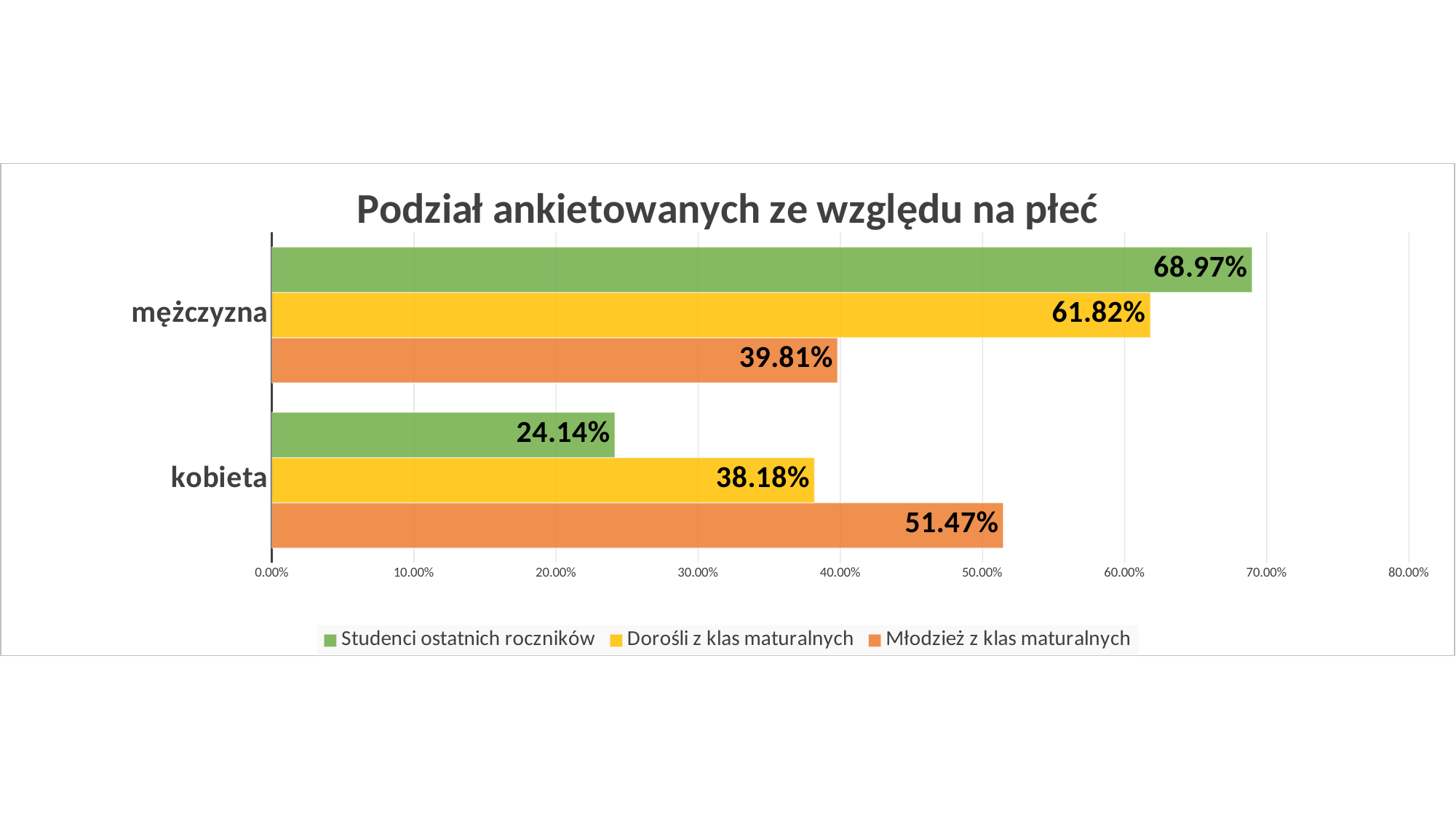
What is the value for mężczyzna in the Studenci ostatnich roczników series? 68.97% What is the title of the chart? Podział ankietowanych ze względu na płeć Which series has the highest value for mężczyzna? Studenci ostatnich roczników What is the difference between the mężczyzna and kobieta values in the Dorośli z klas maturalnych series? 23.64% Is the value for mężczyzna in the Młodzież z klas maturalnych series greater or less than 40.00%? less How many series does the legend list? 3 Which is larger for the Młodzież z klas maturalnych series: mężczyzna or kobieta? kobieta What kind of chart is shown on the slide? bar chart How many categories are shown on the vertical axis? 2 Which series has the lowest value for kobieta? Studenci ostatnich roczników What is the value for kobieta in the Młodzież z klas maturalnych series? 51.47% What is the value for kobieta in the Dorośli z klas maturalnych series? 38.18%